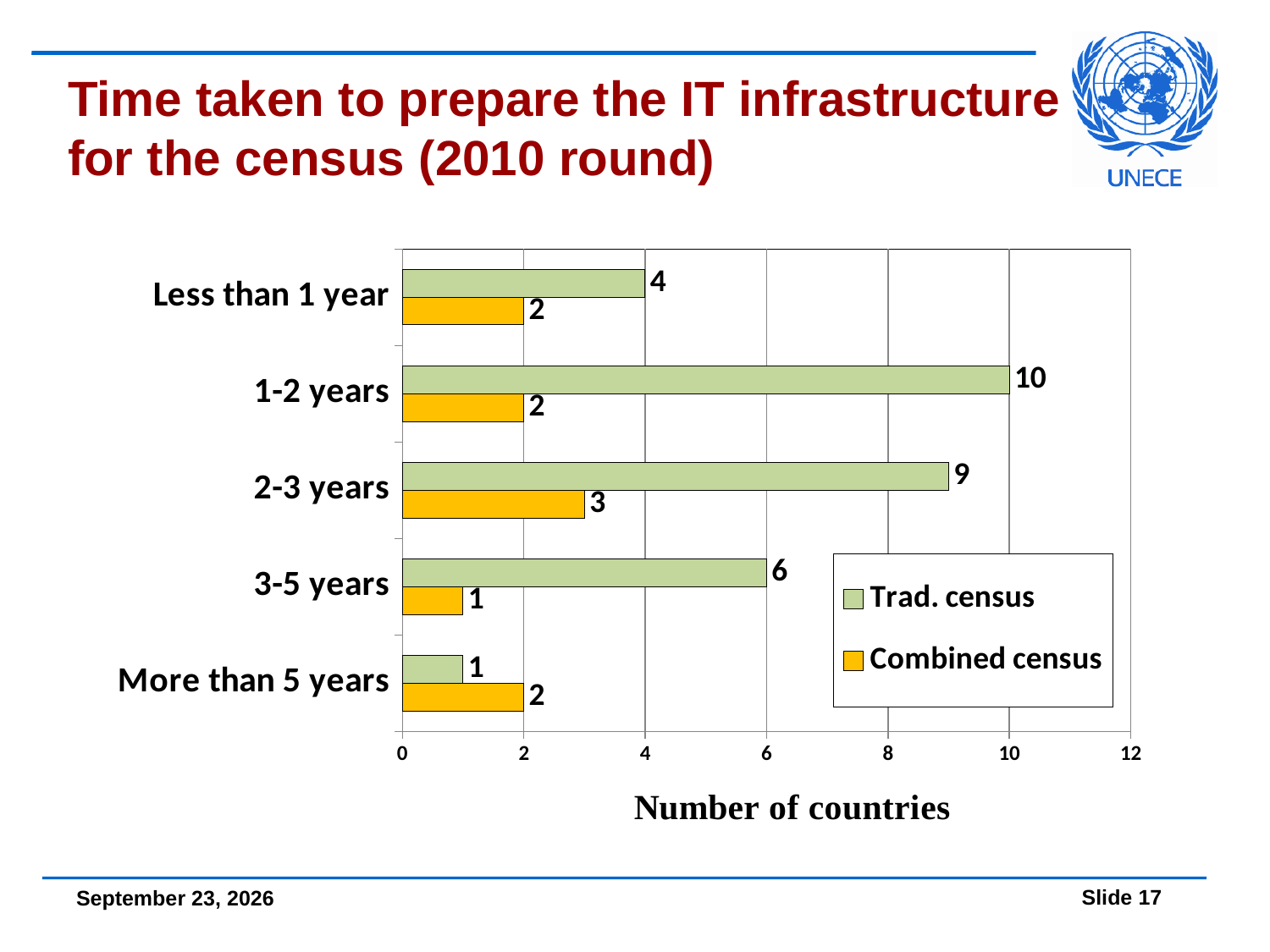
What is the difference between the Trad. census and Combined census values for the 1-2 years category? 8 What is the value for Trad. census in the 'More than 5 years' category? 1 For the 'More than 5 years' category, which series has the larger value, Trad. census or Combined census? Combined census Which time category has the highest number of countries for Trad. census? 1-2 years Which time category has the lowest number of countries for Trad. census? More than 5 years How many series does the legend list? 2 How many time categories are shown on the chart? 5 What colour are the bars for Combined census? Yellow What kind of chart is shown on the slide? Bar chart What is the label of the horizontal axis? Number of countries How many countries with a traditional census took 1-2 years to prepare the IT infrastructure? 10 How many countries with a combined census took 2-3 years to prepare the IT infrastructure? 3